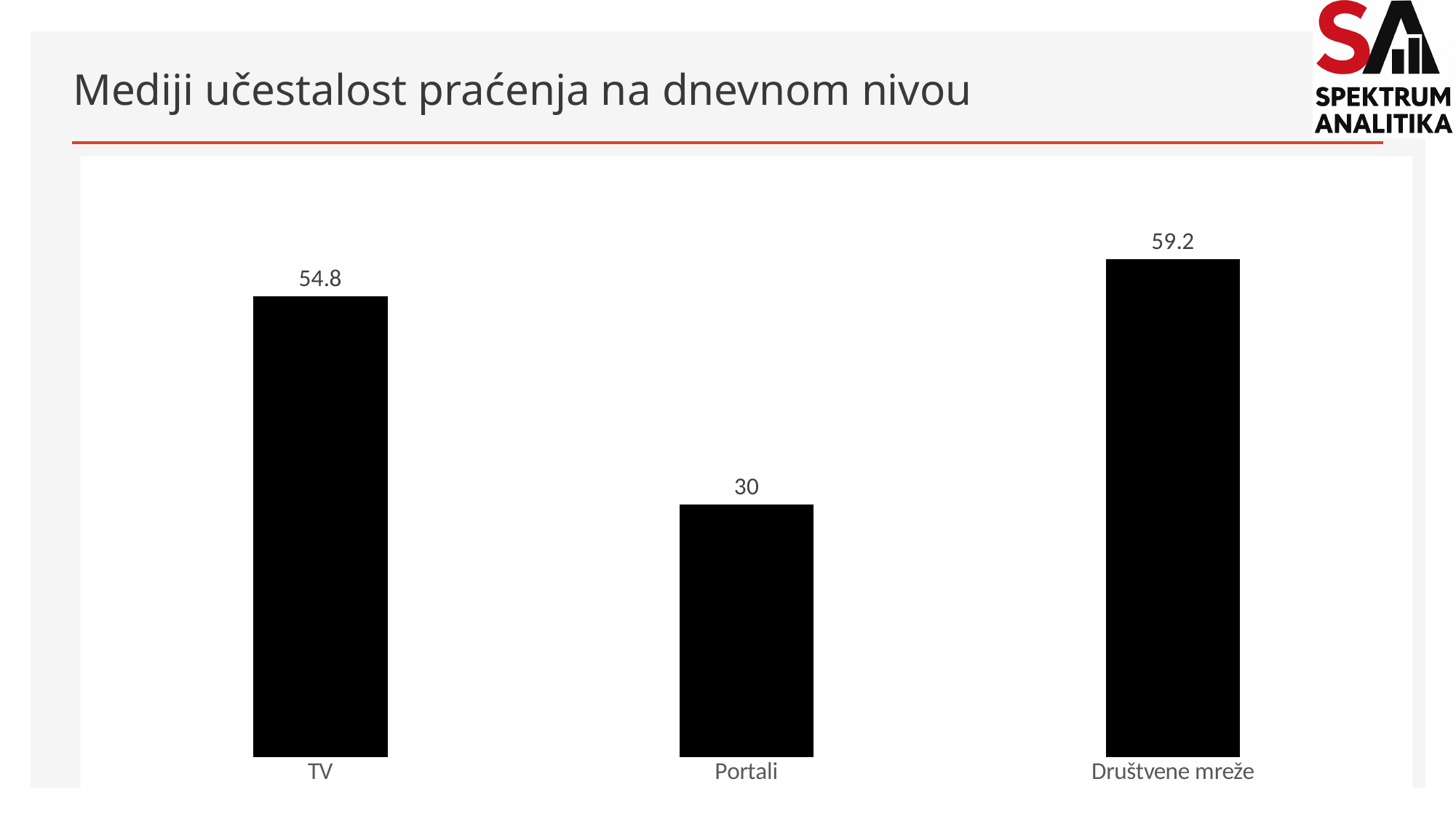
What is the difference between the values for TV and Portali? 24.8 Which is larger, the value for TV or the value for Portali? TV What is the value for Društvene mreže? 59.2 How many categories are shown in the chart? 3 What is the difference between the values for Društvene mreže and TV? 4.4 What is the value for Portali? 30 What is the value for TV? 54.8 What kind of chart is shown on the slide? Bar chart Which is larger, the value for Portali or the value for Društvene mreže? Društvene mreže Which category has the highest value? Društvene mreže What is the title of the slide? Mediji učestalost praćenja na dnevnom nivou Which category has the lowest value? Portali